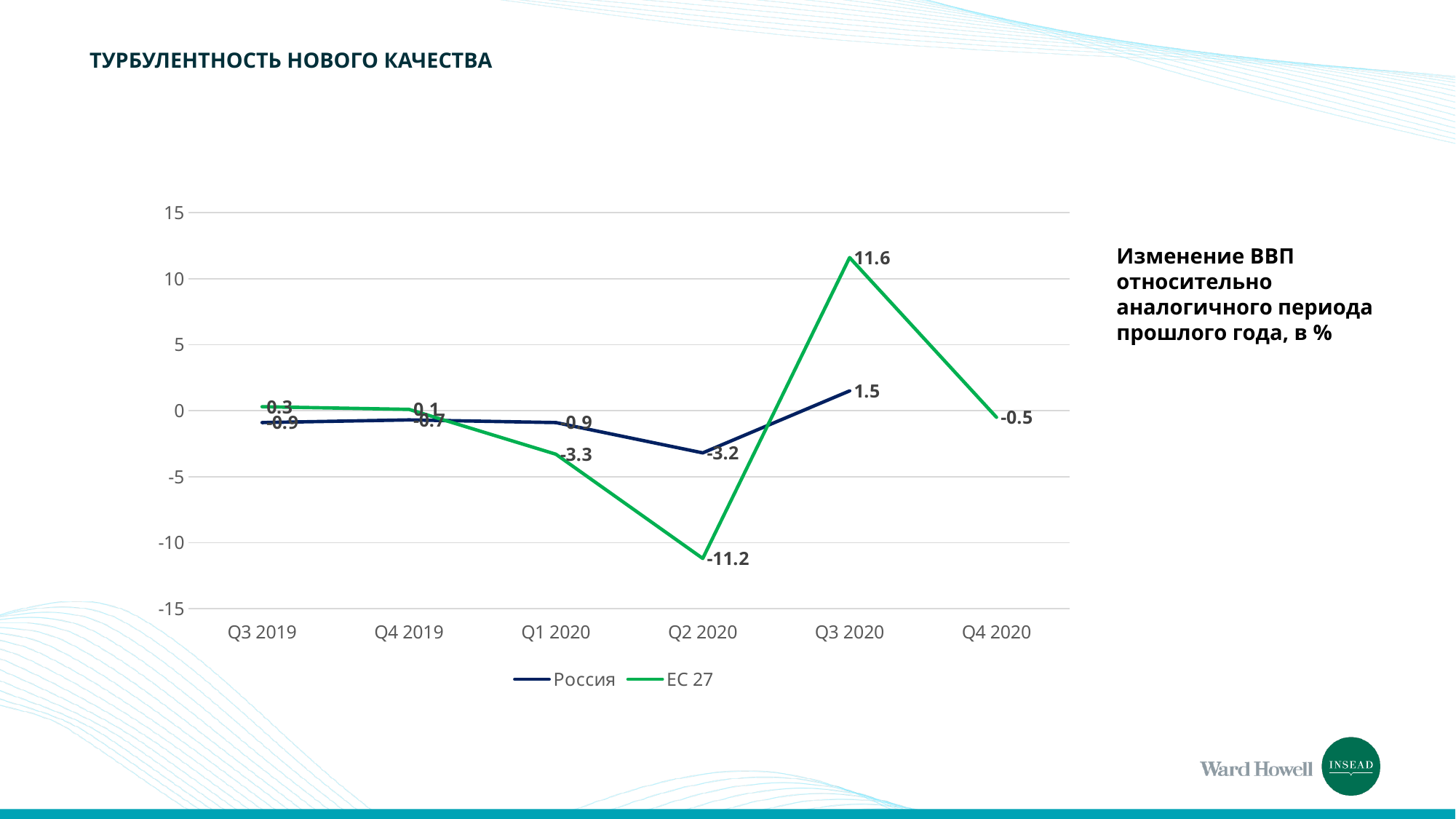
How many quarters are shown on the x axis? 6 How many series does the legend list? 2 In which quarter does ЕС 27 reach its lowest value? Q2 2020 Does the ЕС 27 line rise or fall from Q3 2019 to Q2 2020? fall What is the value for ЕС 27 in Q2 2020? -11.2 What type of chart is shown on the slide? line chart In which quarter does Россия reach its highest value? Q3 2020 What is the difference between the ЕС 27 value and the Россия value in Q3 2020? 10.1 What is the value for ЕС 27 in Q4 2020? -0.5 In Q2 2020, which series has the lower value, Россия or ЕС 27? ЕС 27 What is the value for ЕС 27 in Q3 2020? 11.6 What is the value for Россия in Q3 2020? 1.5